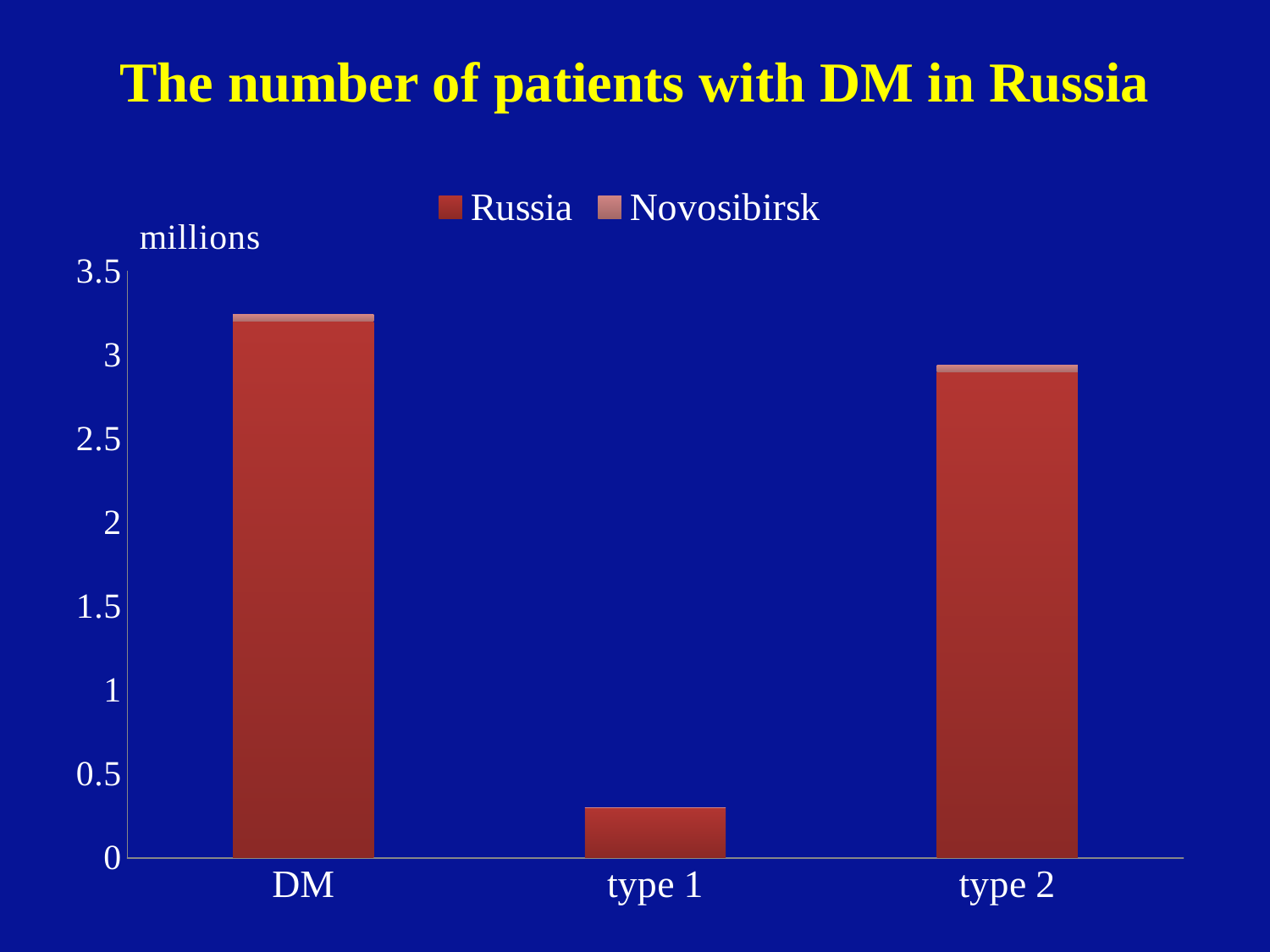
How many categories are shown on the x axis of the chart? 3 Which bar is taller, type 1 or type 2? type 2 Is the value for type 2 greater or less than 2.5? greater Is the value for type 1 greater or less than 0.5? less What unit is shown above the y axis of the chart? millions Is the value for DM greater or less than 3? greater How many series does the chart's legend list? 2 What kind of chart is shown on the slide? bar chart Which category has the tallest bar in the chart? DM Which category has the shortest bar in the chart? type 1 What is the title of the chart on the slide? The number of patients with DM in Russia